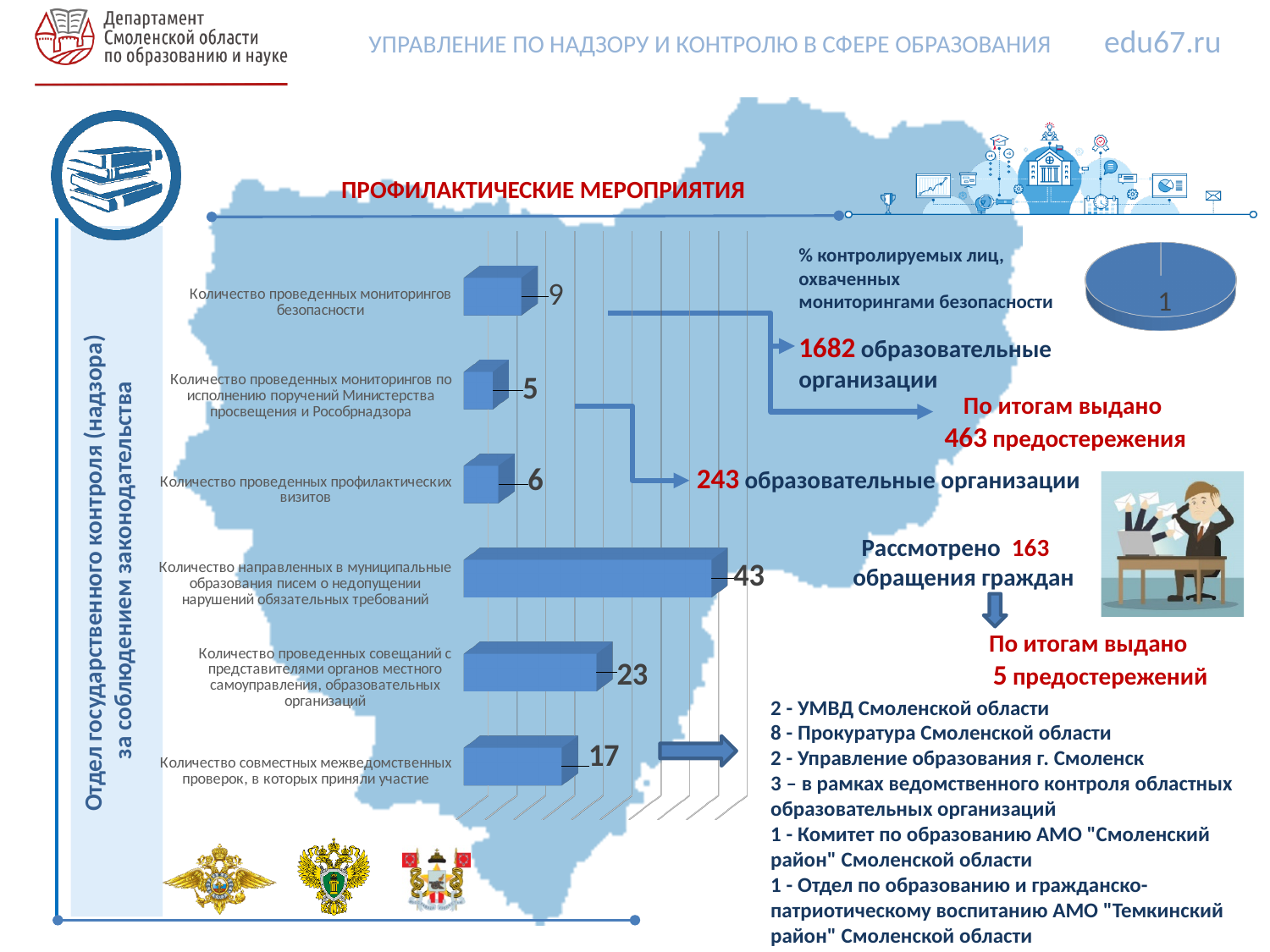
In the bar chart under 'ПРОФИЛАКТИЧЕСКИЕ МЕРОПРИЯТИЯ', which category has the highest value? Количество направленных в муниципальные образования писем о недопущении нарушений обязательных требований In the bar chart under the heading 'ПРОФИЛАКТИЧЕСКИЕ МЕРОПРИЯТИЯ', what is the value for 'Количество проведенных мониторингов безопасности'? 9 In the bar chart under 'ПРОФИЛАКТИЧЕСКИЕ МЕРОПРИЯТИЯ', what is the value for 'Количество проведенных совещаний с представителями органов местного самоуправления, образовательных организаций'? 23 What value is printed on the pie chart in the top right of the slide? 1 In the bar chart under 'ПРОФИЛАКТИЧЕСКИЕ МЕРОПРИЯТИЯ', what is the value for 'Количество проведенных профилактических визитов'? 6 What kind of chart is shown in the top right of the slide next to '% контролируемых лиц, охваченных мониторингами безопасности'? Pie chart In the bar chart under 'ПРОФИЛАКТИЧЕСКИЕ МЕРОПРИЯТИЯ', what is the difference between the number of letters sent to municipalities (43) and the number of meetings held (23)? 20 What kind of chart is shown under the heading 'ПРОФИЛАКТИЧЕСКИЕ МЕРОПРИЯТИЯ'? Bar chart In the bar chart under 'ПРОФИЛАКТИЧЕСКИЕ МЕРОПРИЯТИЯ', which is larger: the number of safety monitorings or the number of preventive visits? Количество проведенных мониторингов безопасности How many categories does the bar chart under 'ПРОФИЛАКТИЧЕСКИЕ МЕРОПРИЯТИЯ' show? 6 In the bar chart under 'ПРОФИЛАКТИЧЕСКИЕ МЕРОПРИЯТИЯ', which category has the lowest value? Количество проведенных мониторингов по исполнению поручений Министерства просвещения и Рособрнадзора In the bar chart under 'ПРОФИЛАКТИЧЕСКИЕ МЕРОПРИЯТИЯ', what is the value for 'Количество совместных межведомственных проверок, в которых приняли участие'? 17